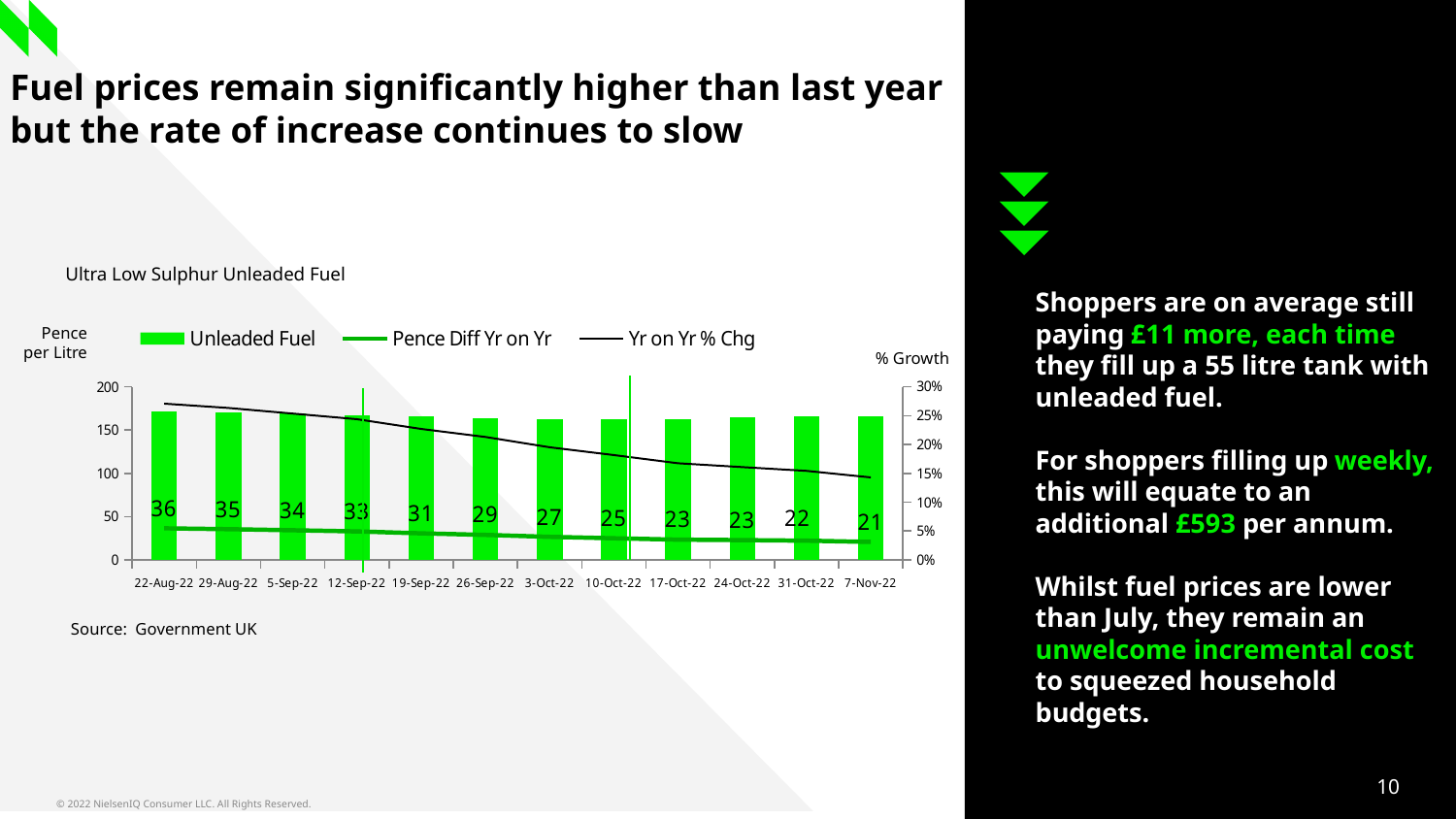
What is the Pence Diff Yr on Yr value for 7-Nov-22? 21 How many dates are shown on the x axis of the chart? 12 Which date has the lowest Pence Diff Yr on Yr value? 7-Nov-22 Does the Pence Diff Yr on Yr series rise or fall from 22-Aug-22 to 7-Nov-22? fall What is the Pence Diff Yr on Yr value for 26-Sep-22? 29 Which date has the highest Pence Diff Yr on Yr value? 22-Aug-22 What is the difference between the Pence Diff Yr on Yr values for 22-Aug-22 and 7-Nov-22? 15 Which has the larger Pence Diff Yr on Yr value, 5-Sep-22 or 3-Oct-22? 5-Sep-22 What is the Pence Diff Yr on Yr value for 22-Aug-22? 36 Is the Unleaded Fuel value for 22-Aug-22 greater or less than 150 pence per litre? greater Is the Yr on Yr % Chg value for 7-Nov-22 greater or less than 20%? less How many series does the chart legend list? 3